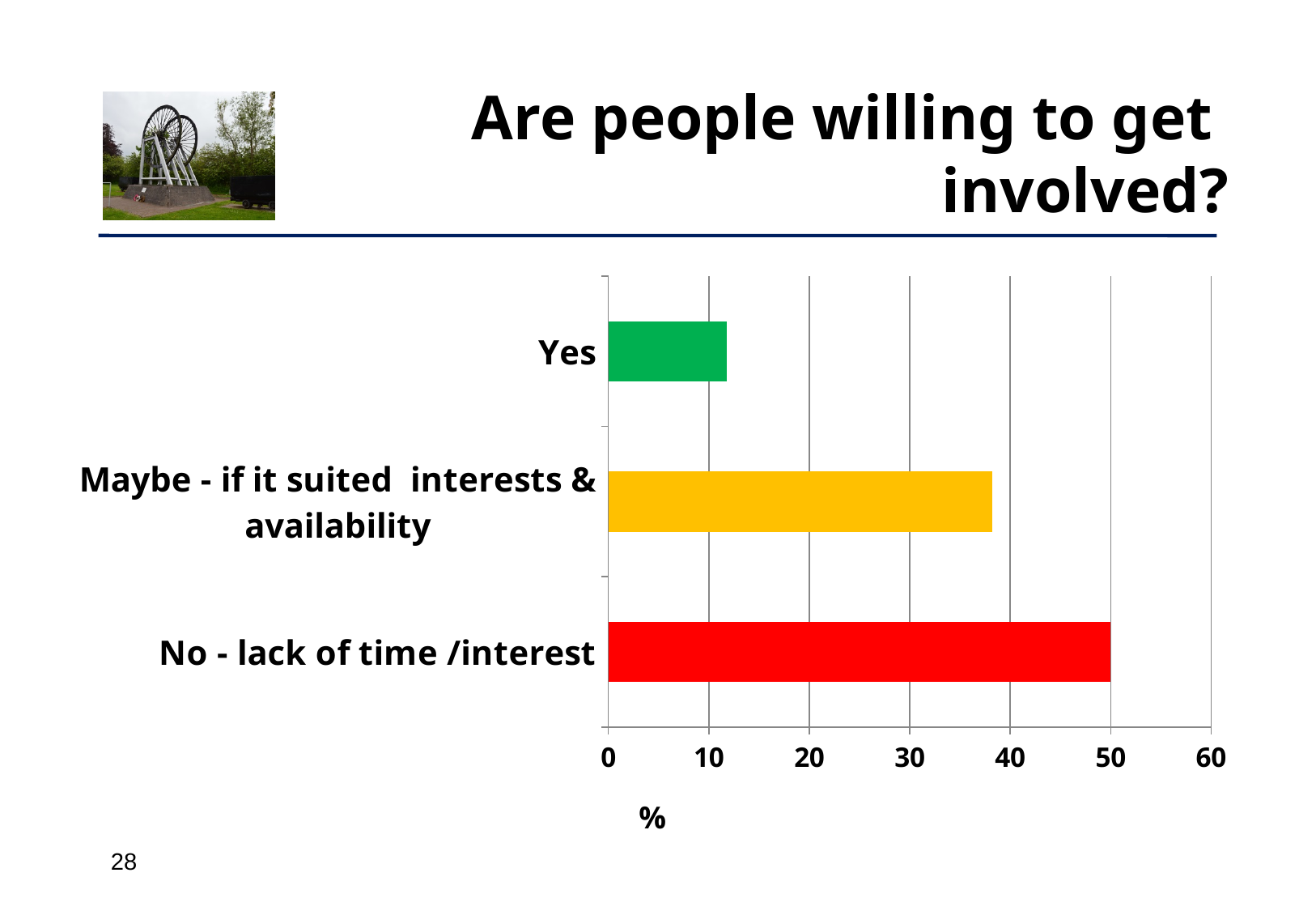
What kind of chart is shown on the slide? bar chart What is the value for No - lack of time /interest? 50 Which category has the highest value? No - lack of time /interest How many categories are plotted in the chart? 3 Is the value for Maybe - if it suited interests & availability greater or less than 40? less Which category has the lowest value? Yes Which is larger, the value for Yes or the value for Maybe - if it suited interests & availability? Maybe - if it suited interests & availability Is the value for Maybe - if it suited interests & availability greater or less than 30? greater What is the title of the chart on the slide? Are people willing to get involved? Is the value for No - lack of time /interest greater or less than 40? greater What label is shown on the horizontal axis of the chart? %